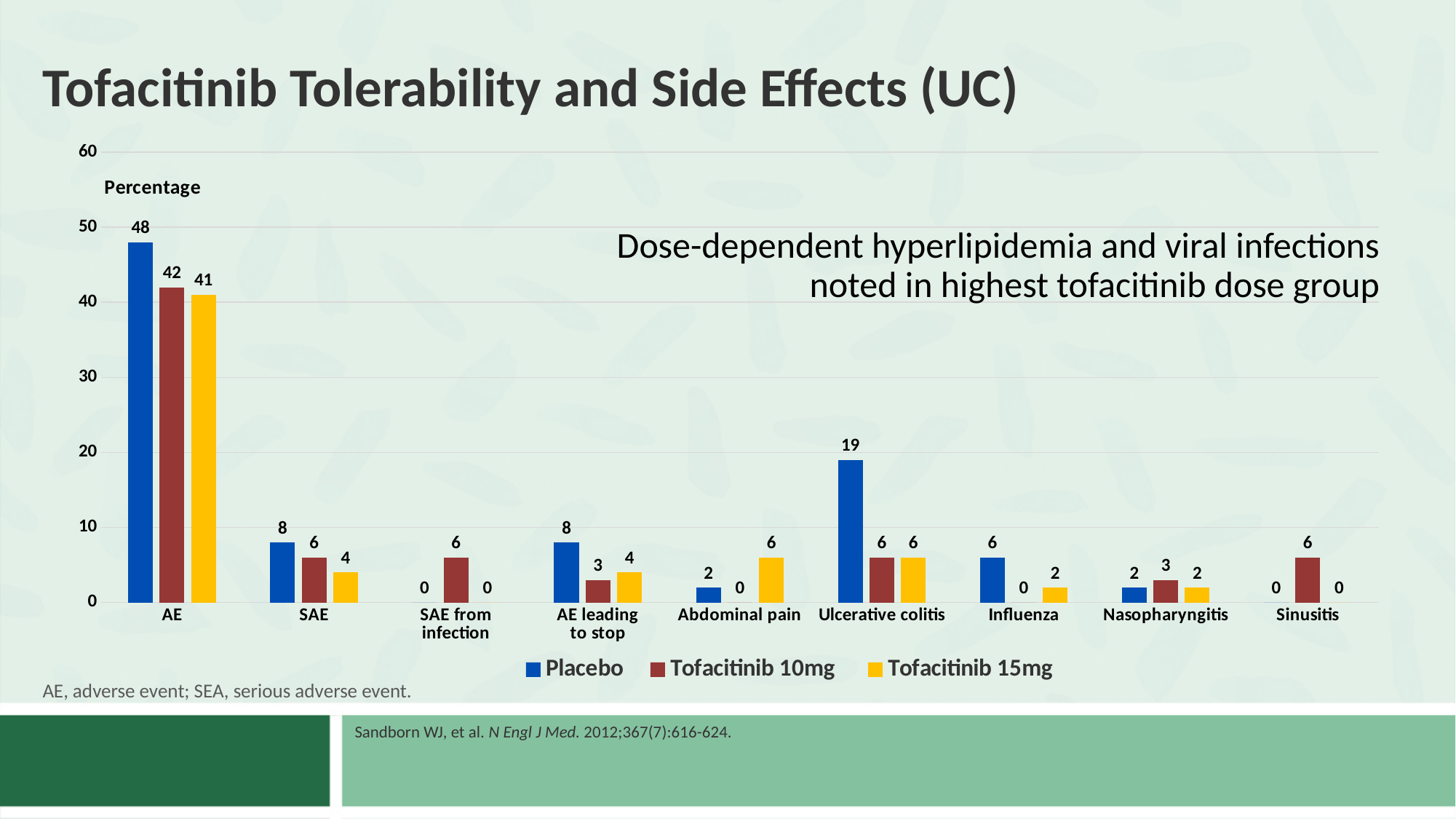
What kind of chart is shown on the slide? bar chart How many series does the legend list? 3 Is the Placebo value for AE greater or less than 40? greater What is the Placebo value for AE? 48 Which colour represents Tofacitinib 15mg in the legend? yellow What is the Tofacitinib 15mg value for Abdominal pain? 6 Which is larger for Influenza: the Placebo value or the Tofacitinib 15mg value? Placebo What is the Tofacitinib 10mg value for Nasopharyngitis? 3 What is the difference between the Placebo and Tofacitinib 10mg values for Ulcerative colitis? 13 Which category has the highest Placebo value? AE What is the Tofacitinib 10mg value for SAE from infection? 6 How many categories are shown on the x axis? 9